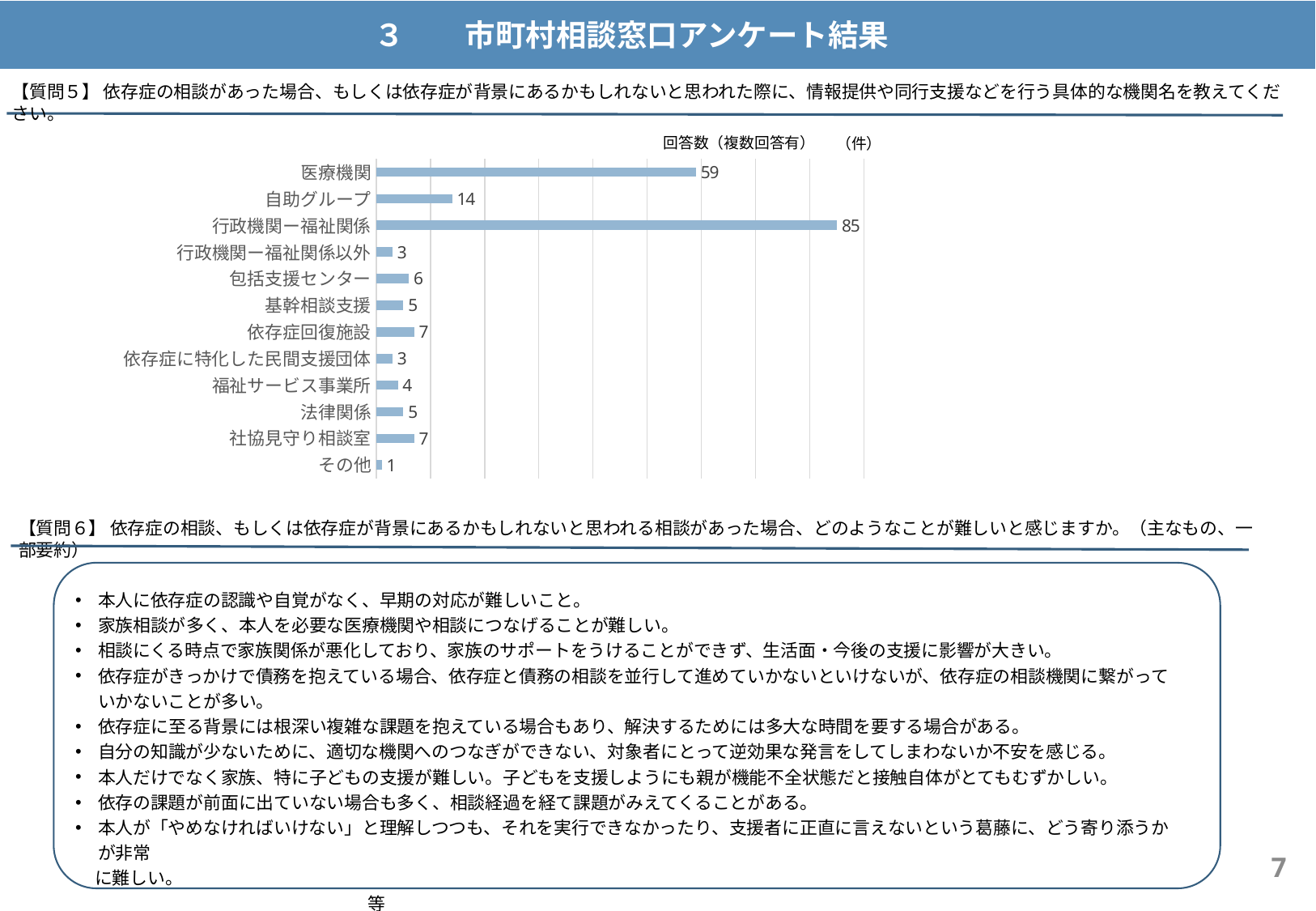
What is the difference between the values for 行政機関ー福祉関係 and 医療機関? 26 What is the title of the chart? 回答数（複数回答有） （件） Which is larger, the value for 依存症回復施設 or the value for 福祉サービス事業所? 依存症回復施設 Which category has the lowest value? その他 What is the value for 包括支援センター? 6 What kind of chart is shown on the slide? Bar chart How many categories are shown in the chart? 12 What is the value for 社協見守り相談室? 7 What is the difference between the values for 自助グループ and 法律関係? 9 Which category has the highest value? 行政機関ー福祉関係 What is the value for 医療機関? 59 What is the value for 自助グループ? 14